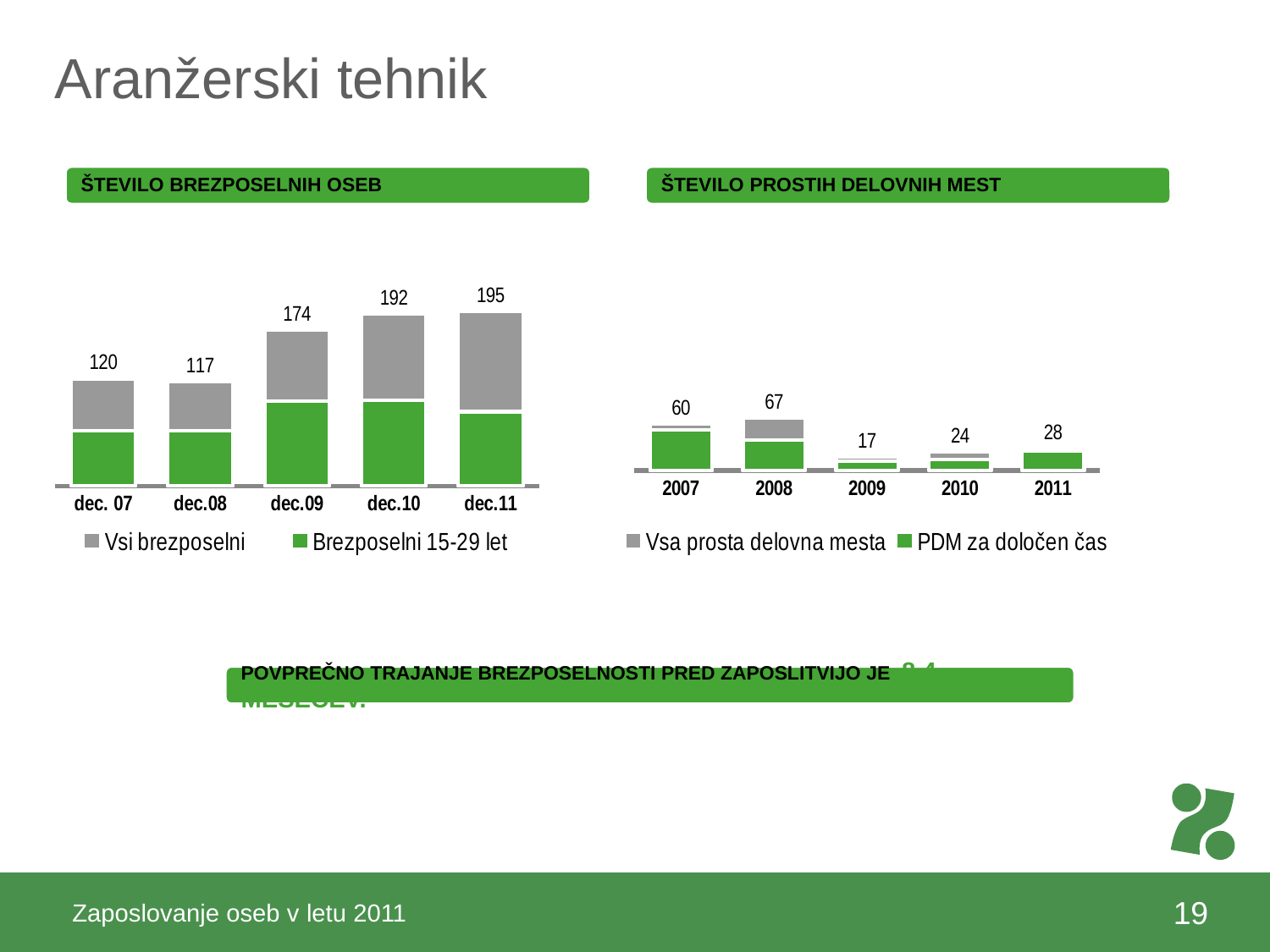
What kind of chart is the chart titled ŠTEVILO PROSTIH DELOVNIH MEST? bar chart In the chart titled ŠTEVILO PROSTIH DELOVNIH MEST, what is the value for Vsa prosta delovna mesta in 2009? 17 In the chart titled ŠTEVILO BREZPOSELNIH OSEB, what is the value for Vsi brezposelni in dec.09? 174 In the chart titled ŠTEVILO BREZPOSELNIH OSEB, how many periods are shown on the x axis? 5 In the chart titled ŠTEVILO BREZPOSELNIH OSEB, what is the value for Vsi brezposelni in dec. 07? 120 In the chart titled ŠTEVILO PROSTIH DELOVNIH MEST, how many series does the legend list? 2 In the chart titled ŠTEVILO PROSTIH DELOVNIH MEST, is the Vsa prosta delovna mesta value for 2007 larger or smaller than the value for 2011? larger In the chart titled ŠTEVILO PROSTIH DELOVNIH MEST, which year has the lowest value for Vsa prosta delovna mesta? 2009 In the chart titled ŠTEVILO PROSTIH DELOVNIH MEST, what is the value for Vsa prosta delovna mesta in 2008? 67 In the chart titled ŠTEVILO BREZPOSELNIH OSEB, which period has the lowest value for Vsi brezposelni? dec.08 In the chart titled ŠTEVILO BREZPOSELNIH OSEB, what is the difference between the Vsi brezposelni values for dec.11 and dec. 07? 75 In the chart titled ŠTEVILO BREZPOSELNIH OSEB, which period has the highest value for Vsi brezposelni? dec.11